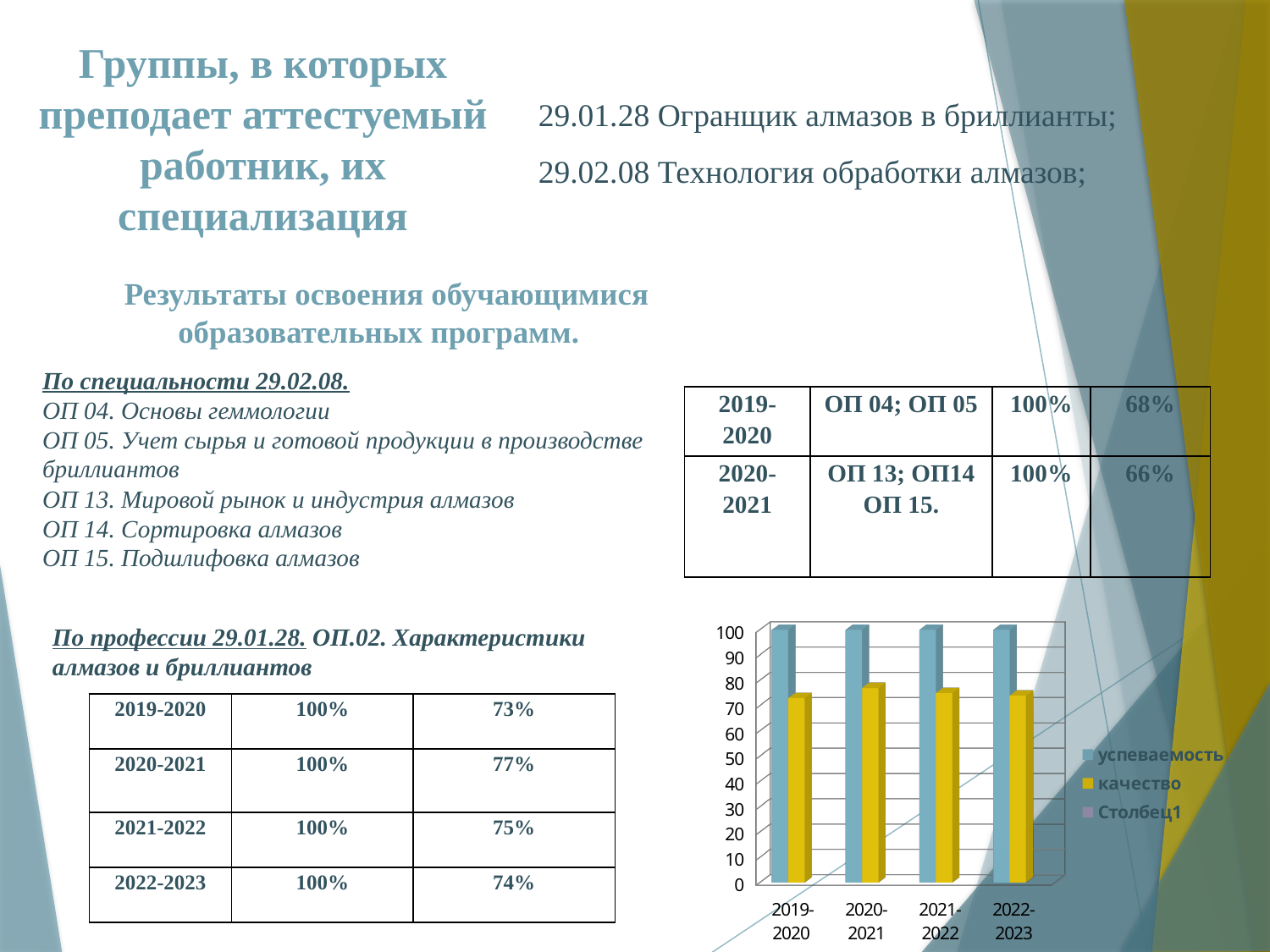
Is the value of качество for 2019-2020 greater or less than 80? less Is the value of качество for 2020-2021 greater or less than 70? greater In 2021-2022, which series has the larger value, успеваемость or качество? успеваемость What is the value of успеваемость for 2022-2023 in the chart? 100 How many year categories are shown on the x axis of the chart? 4 How many series does the chart's legend list? 3 What is the value of успеваемость for 2019-2020 in the chart? 100 What is the name of the third series listed in the chart's legend? Столбец1 Is the value of качество for 2022-2023 greater or less than 90? less Which series in the chart is shown in yellow? качество Does the успеваемость series rise, fall or stay flat across the years on the x axis? stays flat What kind of chart is shown on the slide? bar chart